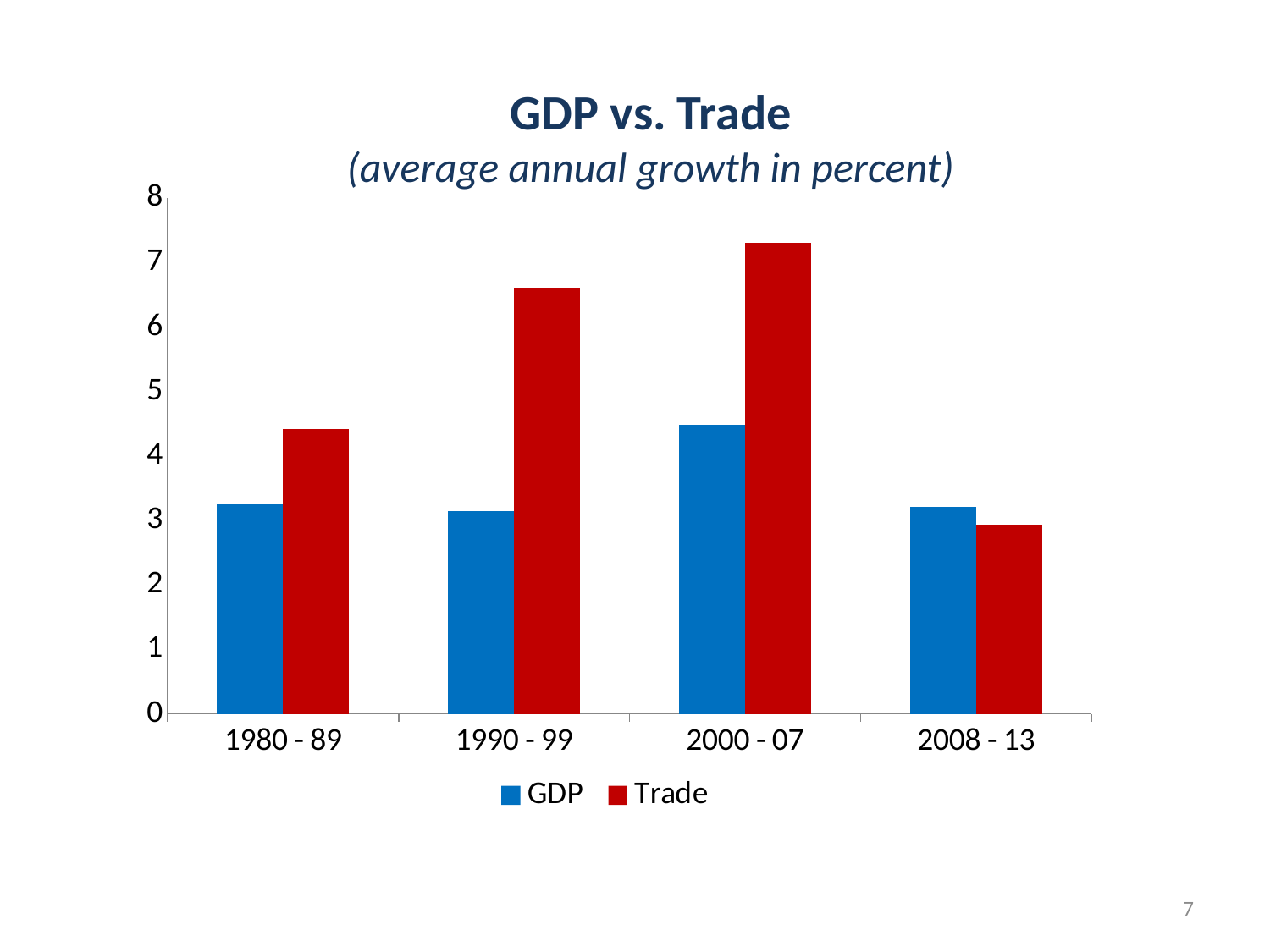
How many time periods are shown on the x axis? 4 In which period is Trade growth lowest? 2008 - 13 Is the GDP value for 2000 - 07 greater or less than 4? greater In which period is Trade growth highest? 2000 - 07 Is the Trade value for 2000 - 07 greater or less than 7? greater What kind of chart is shown on the slide? bar chart Which is larger, Trade growth in 1990 - 99 or Trade growth in 2000 - 07? 2000 - 07 Which colour represents Trade in the chart? red In 2008 - 13, which is larger, GDP growth or Trade growth? GDP Does Trade growth rise or fall from 2000 - 07 to 2008 - 13? fall In which period is GDP growth highest? 2000 - 07 How many series does the legend list? 2